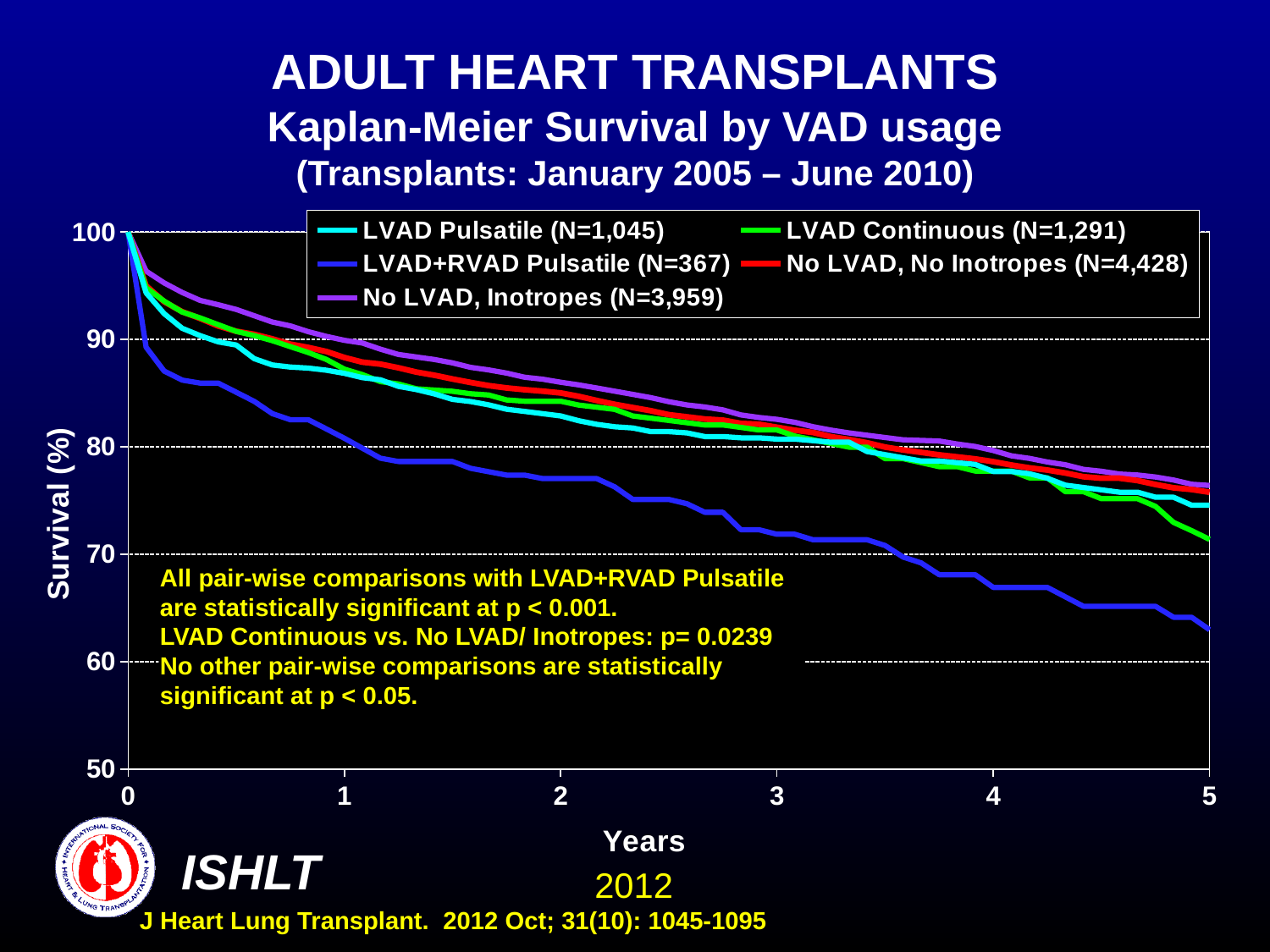
Is the survival for LVAD Continuous at 5 years greater or less than 80? less Which series has the lowest survival at 5 years? LVAD+RVAD Pulsatile Do the survival curves rise or fall as years increase? fall What kind of chart is shown on the slide? line chart At 5 years, which has higher survival: LVAD Continuous or LVAD+RVAD Pulsatile? LVAD Continuous How many series does the legend list? 5 Is the survival for No LVAD, Inotropes at 5 years greater or less than 70? greater Is the survival for LVAD+RVAD Pulsatile at 2 years greater or less than 70? greater Which series has the lowest survival at 1 year? LVAD+RVAD Pulsatile What is the sample size (N) shown in the legend for No LVAD, No Inotropes? 4,428 At 1 year, which has higher survival: No LVAD, Inotropes or LVAD+RVAD Pulsatile? No LVAD, Inotropes